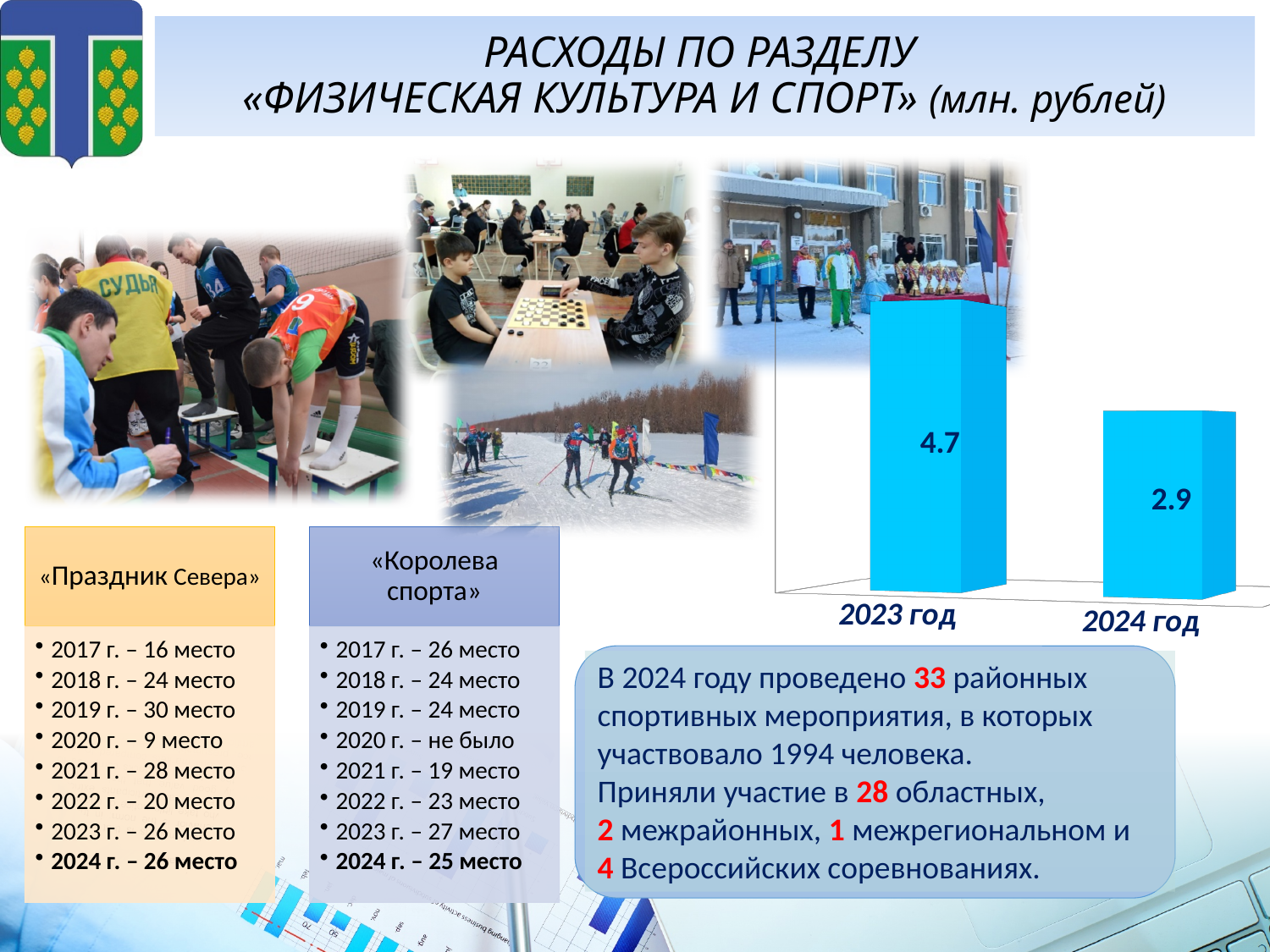
What colour are the bars in the chart? Blue What is the value shown for 2023 год? 4.7 Which year has the highest value in the chart? 2023 год Which year has the lowest value in the chart? 2024 год What is the value shown for 2024 год? 2.9 What kind of chart is shown on the slide? Bar chart How many bars are plotted in the chart? 2 What is the difference between the values for 2023 год and 2024 год? 1.8 Which is larger, the value for 2023 год or for 2024 год? 2023 год Do the values rise or fall from 2023 год to 2024 год? Fall In what units are the chart values expressed, according to the slide title? млн. рублей